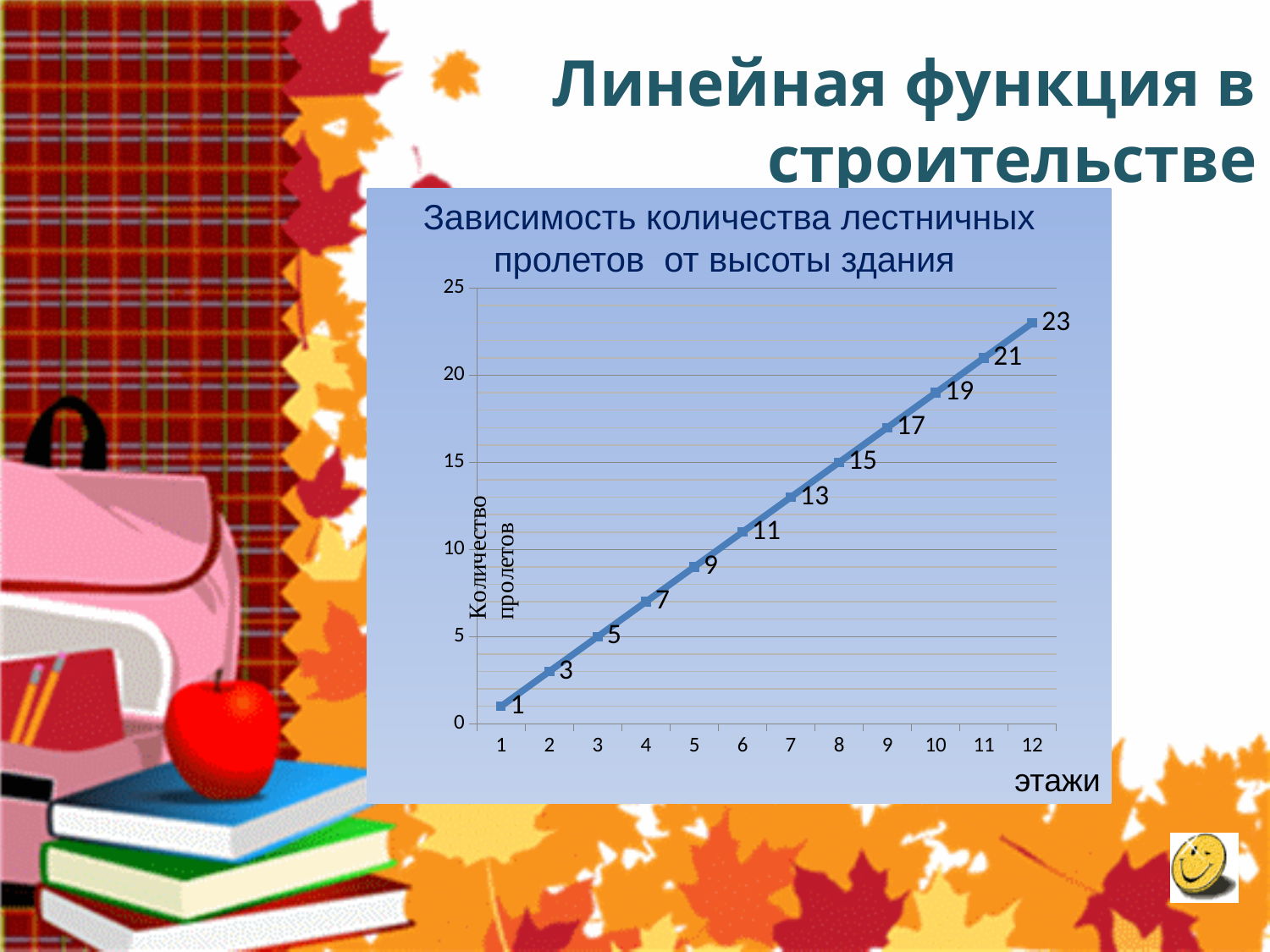
What is the number of stair flights for 12 floors? 23 Which number of floors has the highest number of stair flights? 12 What is the number of stair flights for 1 floor? 1 Do the values rise or fall as the number of floors increases along the x axis? rise What type of chart is shown on the slide? line chart What is the number of stair flights (пролетов) for 5 floors (этажи)? 9 What is the title of the chart? Зависимость количества лестничных пролетов от высоты здания Which number of floors has the lowest number of stair flights? 1 What is the number of stair flights for 8 floors? 15 How many data points are plotted on the chart? 12 Which has more stair flights: 7 floors or 9 floors? 9 floors What is the difference between the number of stair flights for 10 floors and for 3 floors? 14